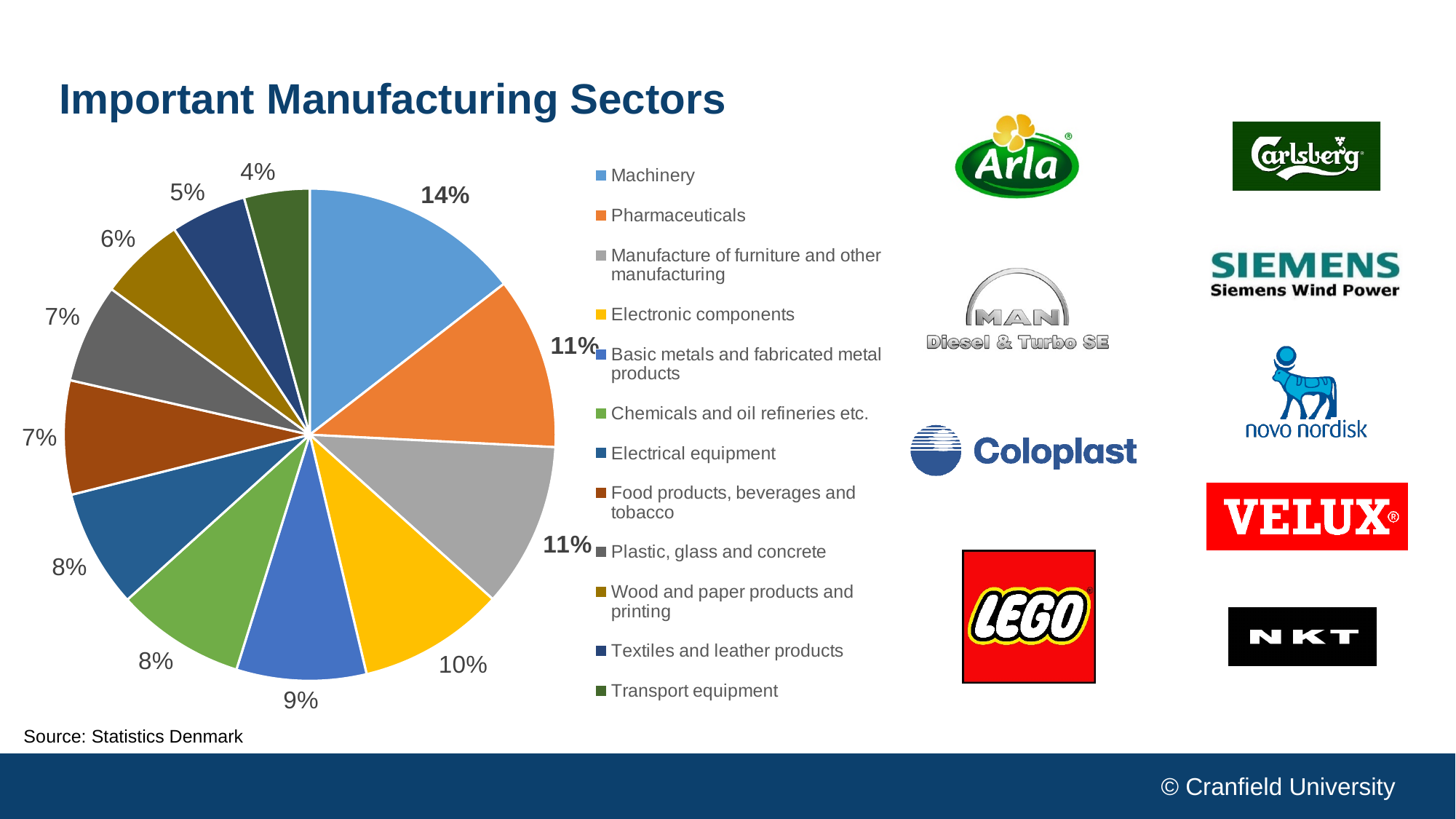
What is the value shown for Pharmaceuticals? 11% What is the value shown for Textiles and leather products? 5% What is the value shown for Electronic components? 10% Which sector has the largest share of the pie? Machinery What is the title of the chart on the slide? Important Manufacturing Sectors What percentage share does Machinery have in the pie chart? 14% What is the value shown for Transport equipment? 4% How many sectors are shown in the pie chart? 12 Which is larger, the share for Wood and paper products and printing or the share for Chemicals and oil refineries etc.? Chemicals and oil refineries etc. What is the difference in percentage points between Machinery and Basic metals and fabricated metal products? 5 What type of chart is shown on the slide? pie chart Which sector has the smallest share of the pie? Transport equipment